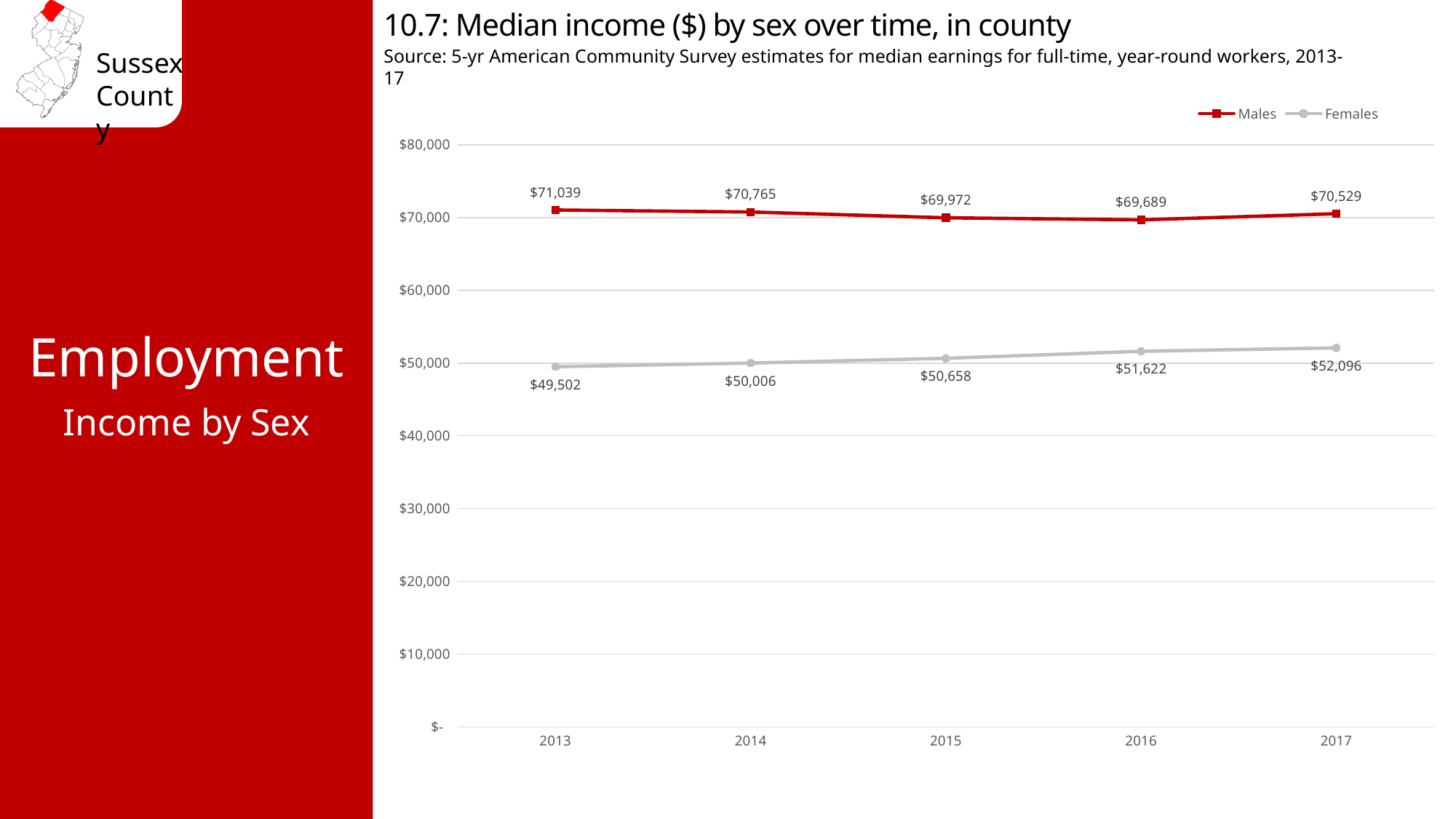
What is the difference between the Males and Females median income in 2017? $18,433 What was the median income for Females in 2015? $50,658 Is the median income for Females in 2016 greater or less than $60,000? less Does the median income for Females rise or fall from 2013 to 2017? rise In which year was the median income for Females highest? 2017 Which series had the higher median income in 2014, Males or Females? Males How many years are shown on the x axis? 5 How many series does the legend list? 2 What kind of chart is shown on the slide? line chart In which year was the median income for Males lowest? 2016 What was the median income for Females in 2017? $52,096 What was the median income for Males in 2013? $71,039